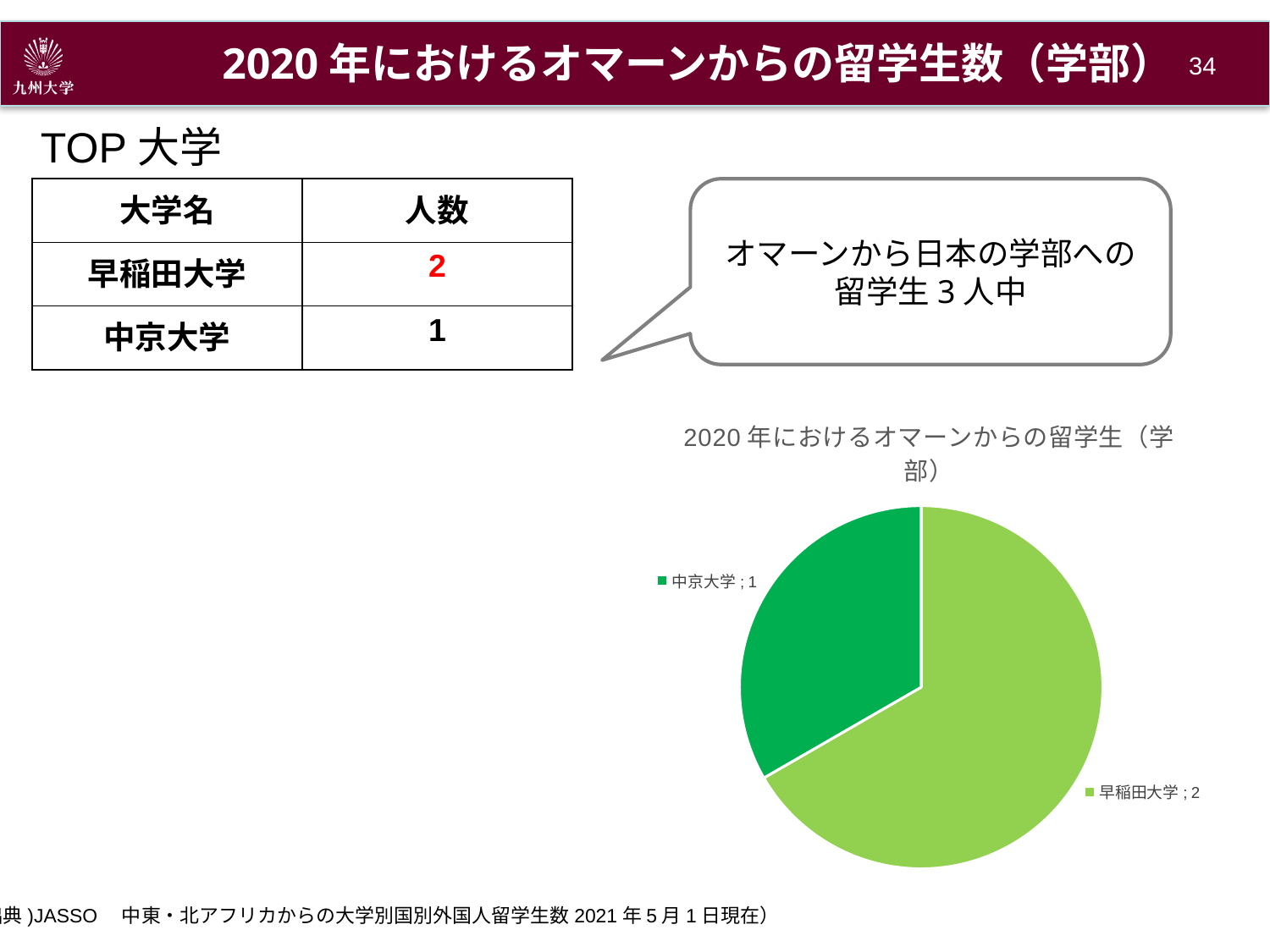
Which university has the smallest slice in the pie chart? 中京大学 Which is larger in the pie chart, the value for 早稲田大学 or 中京大学? 早稲田大学 What kind of chart is shown on the slide? pie chart What share of the pie chart does 早稲田大学 represent? 2/3 What is the value for 中京大学 in the pie chart? 1 What is the value for 早稲田大学 in the pie chart? 2 What is the difference between the values for 早稲田大学 and 中京大学 in the pie chart? 1 How many slices does the pie chart have? 2 What is the title of the pie chart? 2020年におけるオマーンからの留学生（学部） What is the total of all slices in the pie chart? 3 What colour is the 中京大学 slice in the pie chart? dark green Which university has the largest slice in the pie chart? 早稲田大学